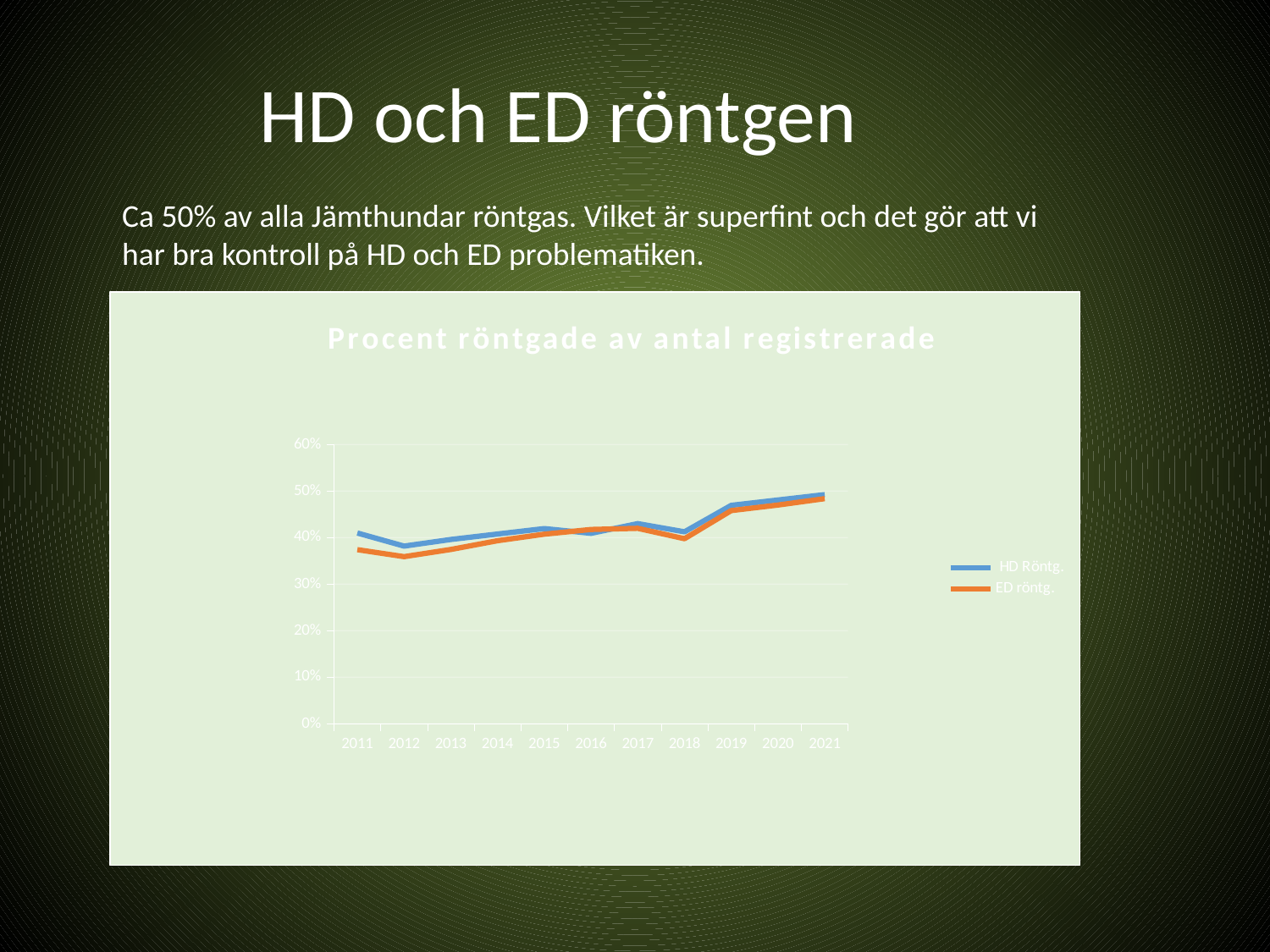
Is the ED röntg. value for 2012 greater or less than 40%? less In which year is the HD Röntg. value lowest? 2012 In which year is the HD Röntg. value highest? 2021 What kind of chart is shown on the slide? line chart Is the HD Röntg. value for 2019 greater or less than 40%? greater Do the HD Röntg. values overall rise or fall from 2011 to 2021? rise How many series does the legend list? 2 How many years are plotted along the x axis? 11 Which series is drawn in orange? ED röntg. What is the title of the chart? Procent röntgade av antal registrerade In which year is the ED röntg. value lowest? 2012 In 2011, which series has the larger value, HD Röntg. or ED röntg.? HD Röntg.